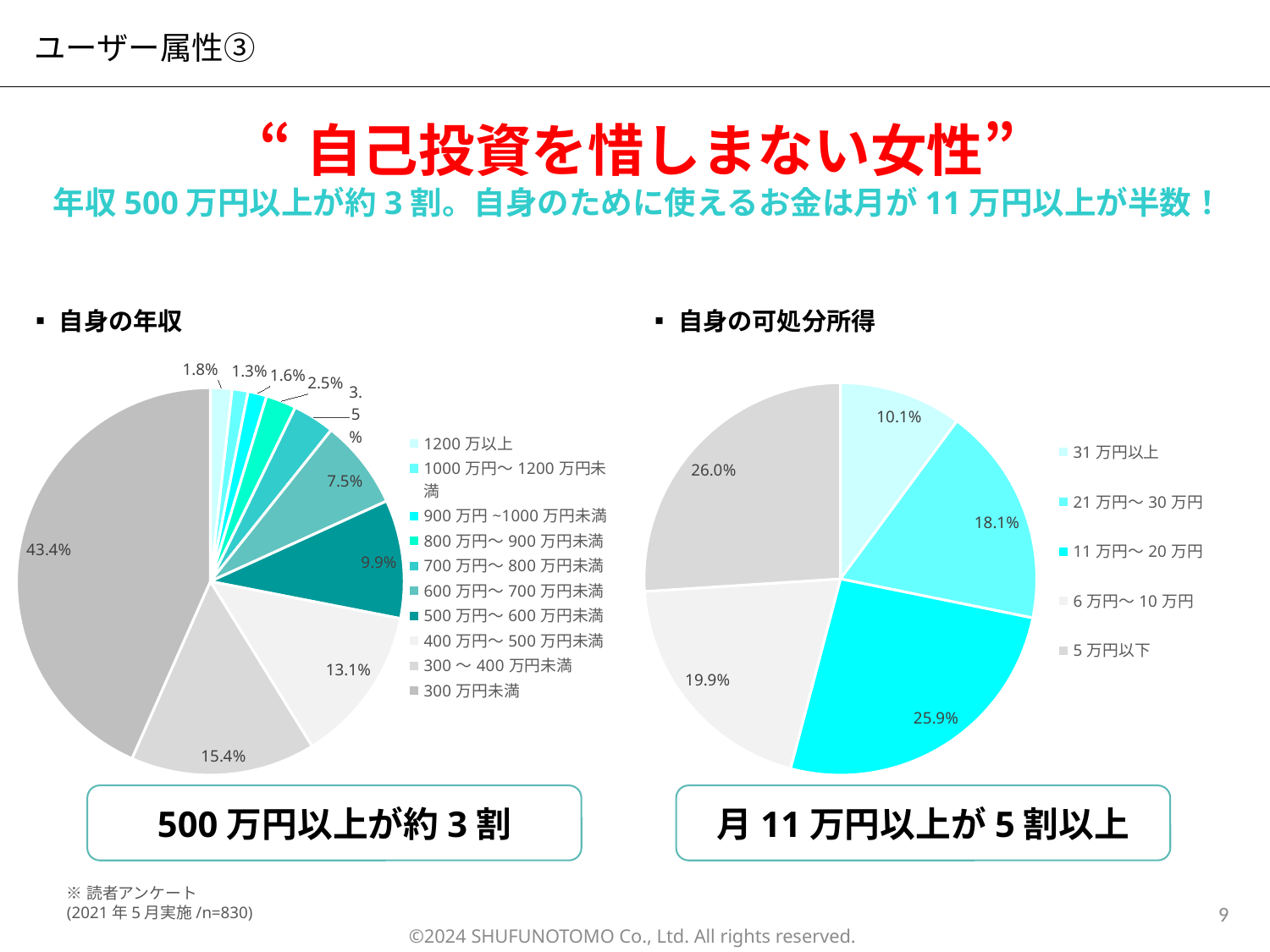
On the 自身の可処分所得 chart, what share is labelled for 5万円以下? 26.0% On the 自身の年収 chart, what is the difference between the 300～400万円未満 slice and the 400万円～500万円未満 slice? 2.3% On the 自身の可処分所得 chart, what is the difference between the 11万円～20万円 slice and the 31万円以上 slice? 15.8% On the 自身の可処分所得 chart, which category has the smallest slice? 31万円以上 On the 自身の年収 chart, how many categories does the legend list? 10 On the 自身の年収 chart, what share is labelled for 300万円未満? 43.4% What kind of chart is used for 自身の年収? Pie chart On the 自身の可処分所得 chart, which is larger: 21万円～30万円 or 6万円～10万円? 6万円～10万円 On the 自身の可処分所得 chart, what share is labelled for 11万円～20万円? 25.9% On the 自身の可処分所得 chart, how many categories does the legend list? 5 On the 自身の年収 chart, what share is labelled for 500万円～600万円未満? 9.9% On the 自身の年収 chart, which category has the largest slice? 300万円未満